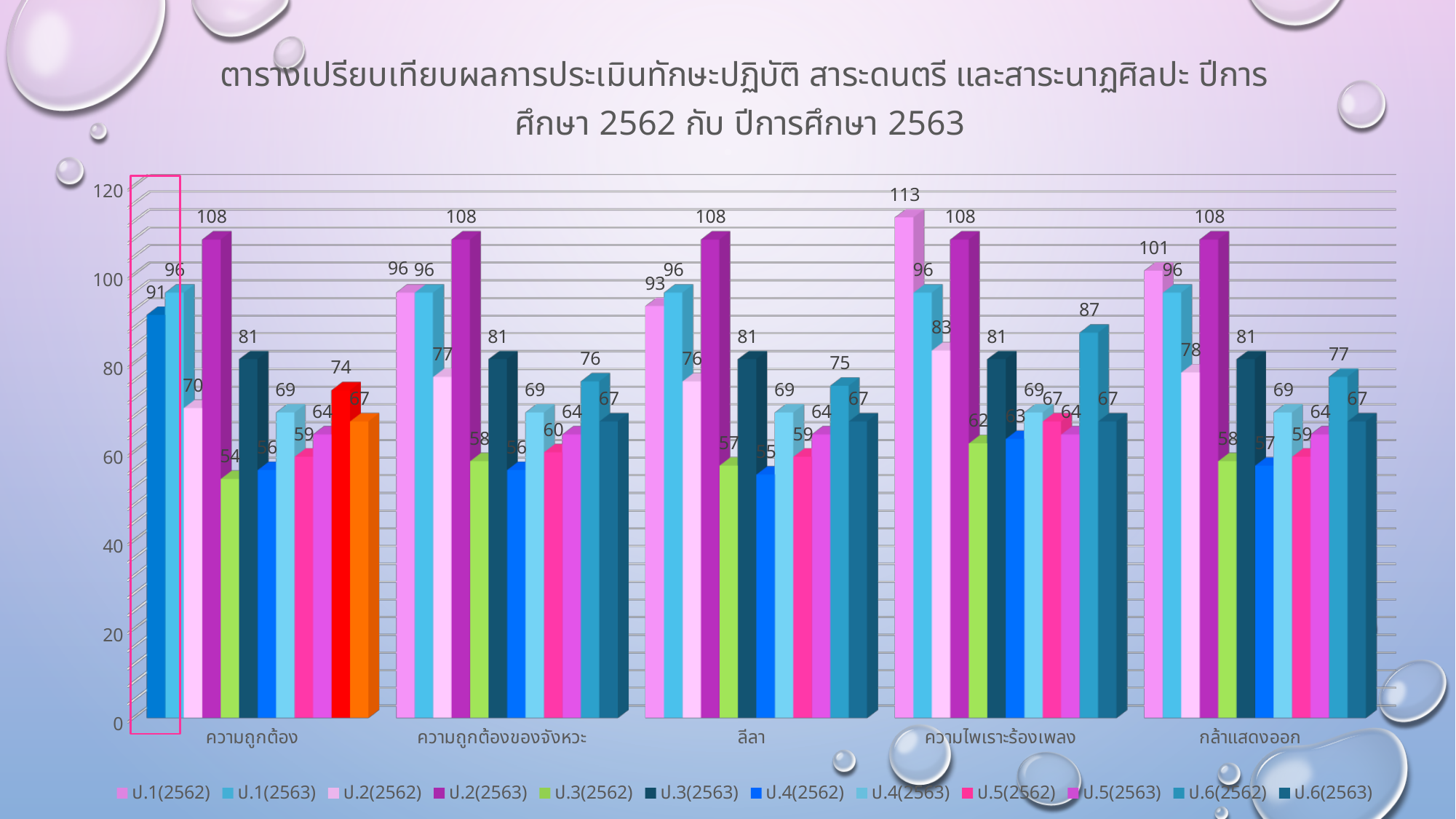
Which series has the lowest value in the ลีลา category? ป.4(2562) In the กล้าแสดงออก category, what is the difference between the values for ป.2(2563) and ป.2(2562)? 30 In the กล้าแสดงออก category, what is the difference between the values for ป.1(2562) and ป.1(2563)? 5 What kind of chart is shown on the slide? bar chart How many categories are shown along the x axis of the chart? 5 What is the value for ป.2(2563) in the ลีลา category? 108 How many series does the chart's legend list? 12 In the ความถูกต้องของจังหวะ category, which is larger: the value for ป.6(2562) or ป.6(2563)? ป.6(2562) What is the value for ป.1(2562) in the ความไพเราะร้องเพลง category? 113 Which series has the highest value in the ความไพเราะร้องเพลง category? ป.1(2562) What is the value for ป.6(2562) in the ความไพเราะร้องเพลง category? 87 What is the value for ป.3(2562) in the ความไพเราะร้องเพลง category? 62